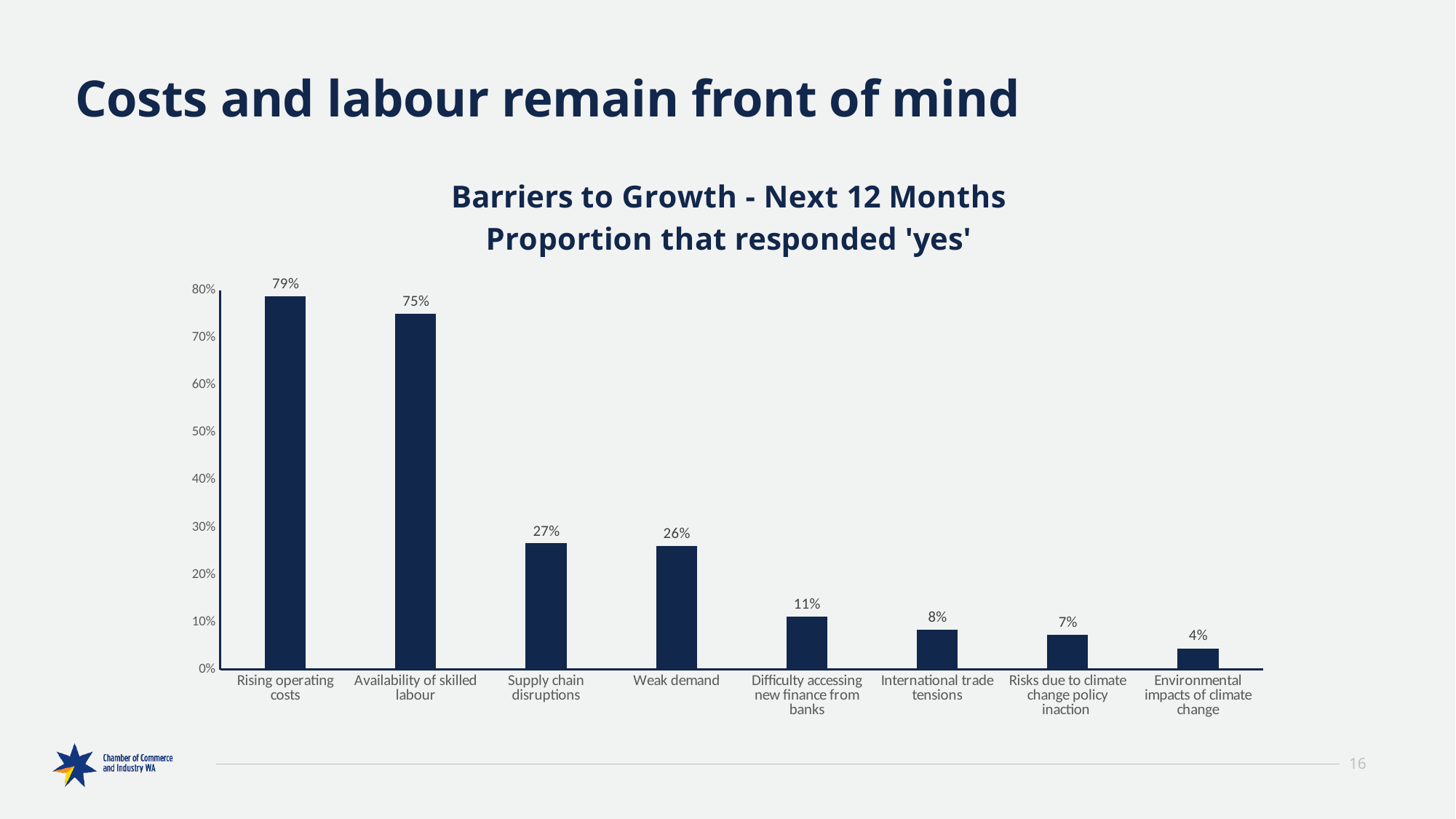
Which barrier has the lowest proportion of 'yes' responses? Environmental impacts of climate change What is the difference between the values for Rising operating costs and Availability of skilled labour? 4% Which barrier has the highest proportion of 'yes' responses? Rising operating costs What proportion of respondents said 'yes' to Rising operating costs as a barrier to growth? 79% What is the difference between the values for Weak demand and Difficulty accessing new finance from banks? 15% Which is larger: the value for International trade tensions or the value for Risks due to climate change policy inaction? International trade tensions What is the value for Environmental impacts of climate change? 4% What is the value for Supply chain disruptions? 27% How many barriers (categories) are shown in the chart? 8 What is the value for Availability of skilled labour? 75% What kind of chart is shown on the slide? Bar chart What is the title of the chart? Barriers to Growth - Next 12 Months Proportion that responded 'yes'